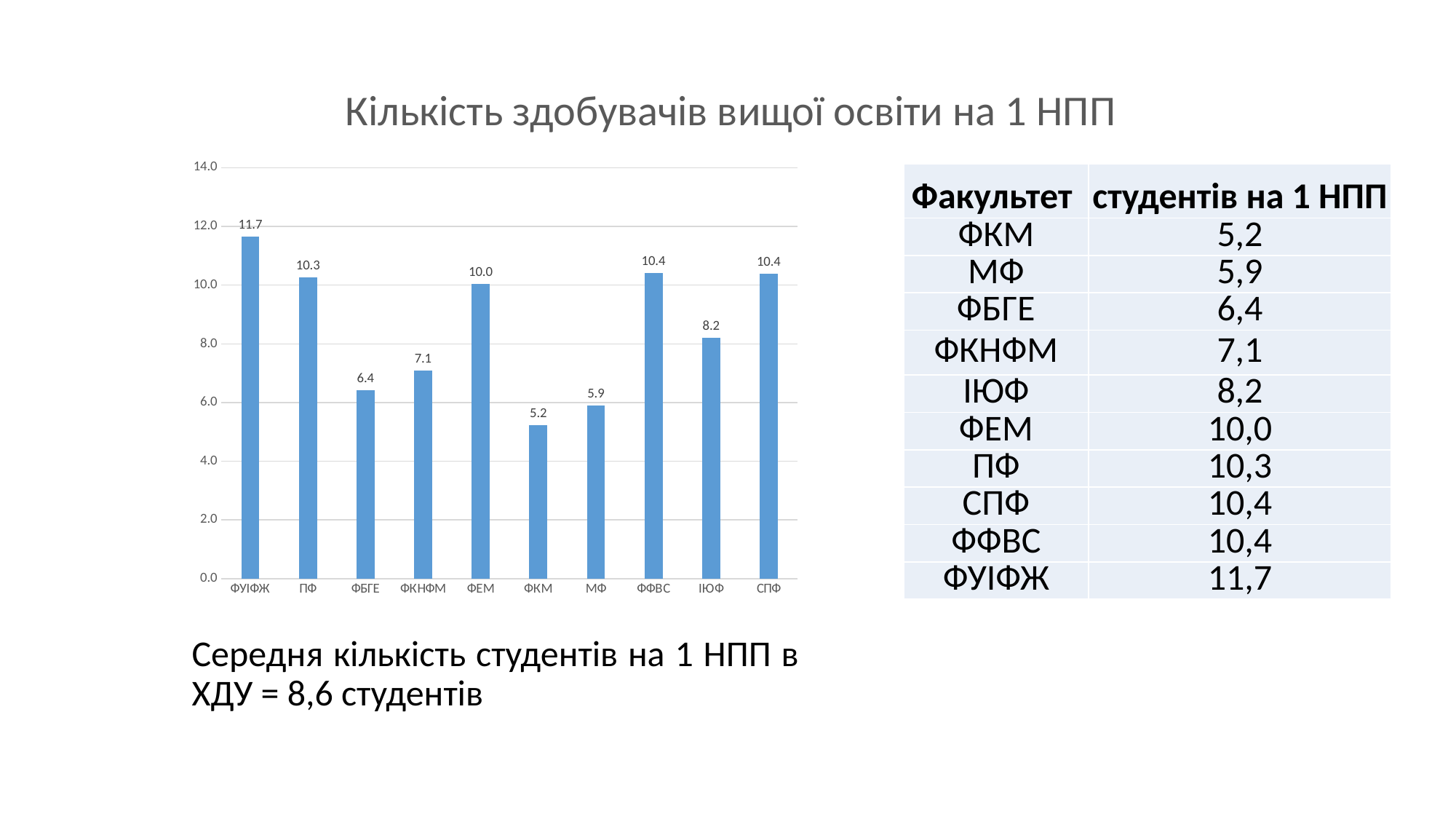
What is the title of the chart on the slide? Кількість здобувачів вищої освіти на 1 НПП How many faculties are shown in the chart? 10 What is the difference between the values for ФУІФЖ and ФКМ? 6.5 Is the value for ІЮФ greater or less than 10.0? less What is the value for ІЮФ in the chart? 8.2 What is the value for ФКНФМ in the chart? 7.1 Which is larger, the value for ФЕМ or the value for МФ? ФЕМ Which faculty has the lowest value in the chart? ФКМ What kind of chart is shown on the slide? bar chart What is the value for ФУІФЖ in the chart? 11.7 What is the difference between the values for ПФ and ФБГЕ? 3.9 Which faculty has the highest value in the chart? ФУІФЖ